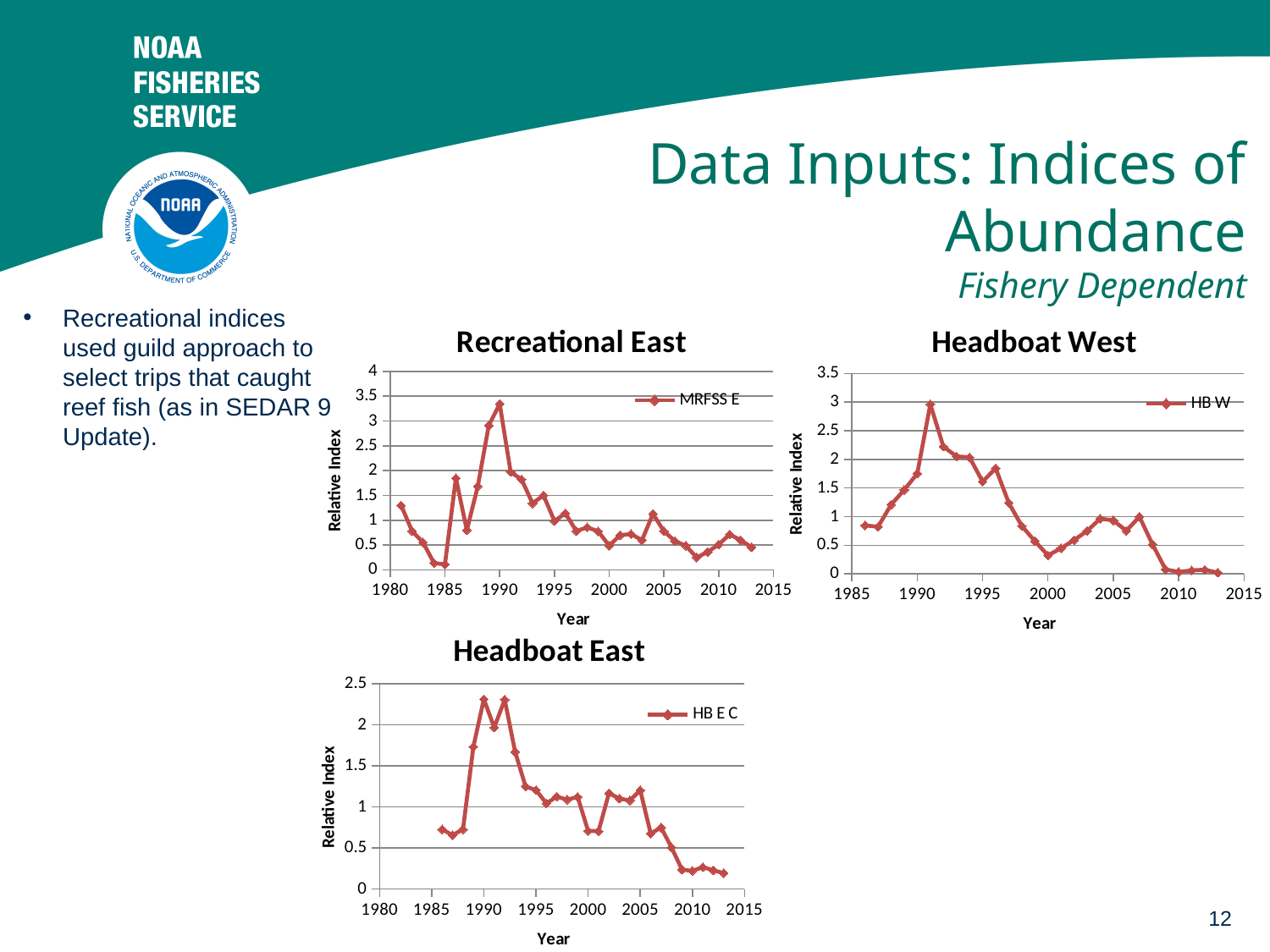
What is the legend entry on the Recreational East chart? MRFSS E In the Recreational East chart, is the value for 1990 greater or less than 3? greater In the Recreational East chart, which year has the highest relative index? 1990 In the Recreational East chart, do the values rise or fall from 1985 to 1990? rise In the Headboat West chart, is the value for 2010 greater or less than 0.5? less In the Headboat West chart, is the value for 2000 greater or less than 0.5? less What kind of chart is the Recreational East chart? line chart How many series does the legend of the Headboat West chart list? 1 In the Headboat East chart, which is larger, the value for 1990 or the value for 2010? 1990 In the Headboat West chart, do the values rise or fall from 2007 to 2013? fall What is the legend entry on the Headboat East chart? HB E C